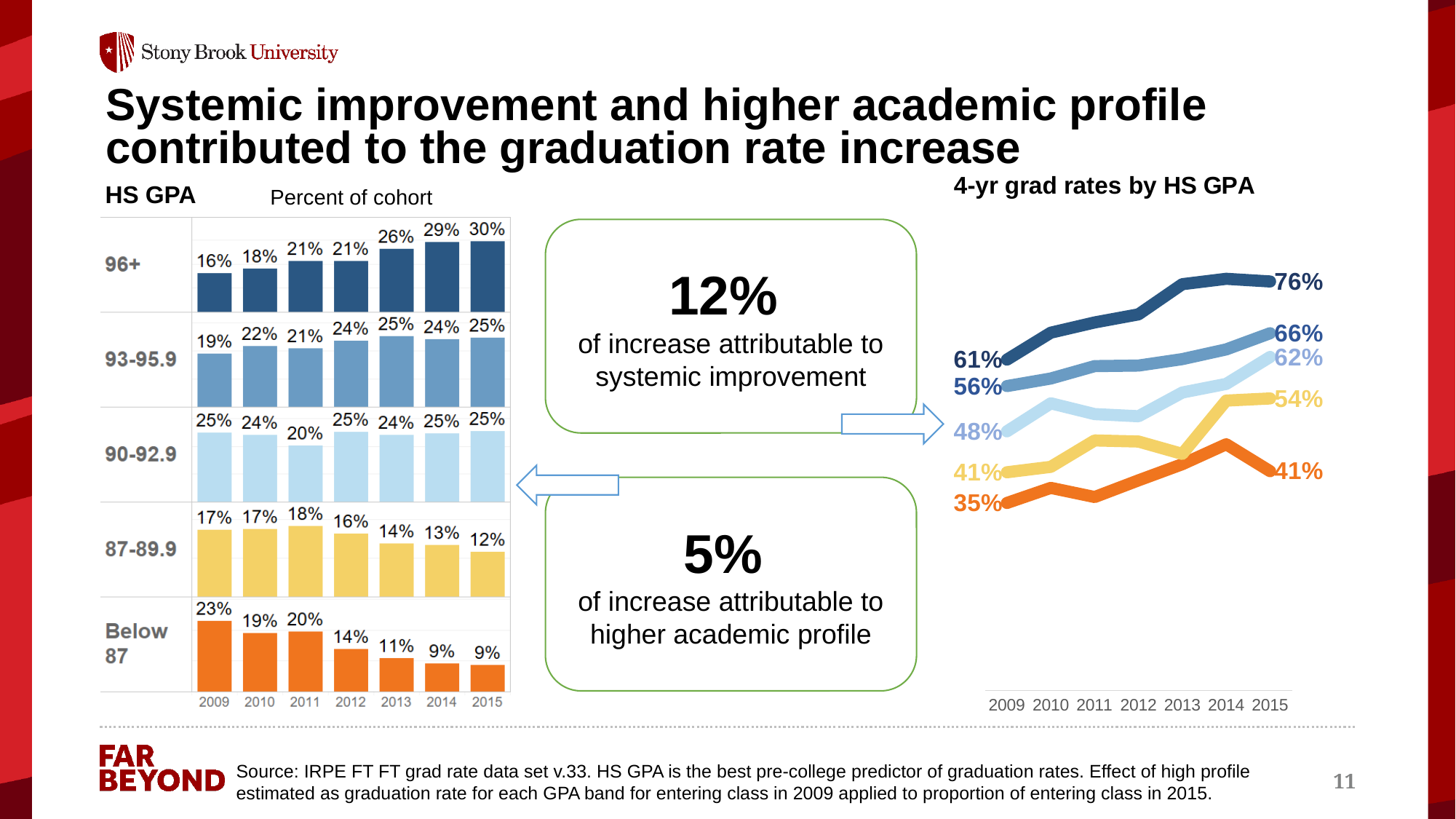
In the '4-yr grad rates by HS GPA' chart, what is the 2015 value of the dark blue (top) line? 76% In the 'Percent of cohort' bar chart, do the values for the Below 87 HS GPA band rise or fall from 2009 to 2015? fall In the 'Percent of cohort' bar chart, what is the value for the 87-89.9 HS GPA band in 2013? 14% In the 'Percent of cohort' bar chart, which year has the highest value for the 96+ HS GPA band? 2015 In the 'Percent of cohort' bar chart, which year has the lowest value for the 90-92.9 HS GPA band? 2011 In the 'Percent of cohort' bar chart, what is the difference between the 2015 and 2009 values for the 96+ HS GPA band? 14% In the 'Percent of cohort' bar chart, which is larger in 2012: the value for 93-95.9 or the value for Below 87? 93-95.9 In the 'Percent of cohort' bar chart, what is the value for the Below 87 HS GPA band in 2009? 23% What kind of chart is the '4-yr grad rates by HS GPA' chart? line chart In the '4-yr grad rates by HS GPA' chart, what is the difference between the 2015 and 2009 values of the orange (bottom) line? 6% In the 'Percent of cohort' bar chart, what is the value for the 96+ HS GPA band in 2015? 30% In the 'Percent of cohort' bar chart, how many years are shown on the x axis? 7